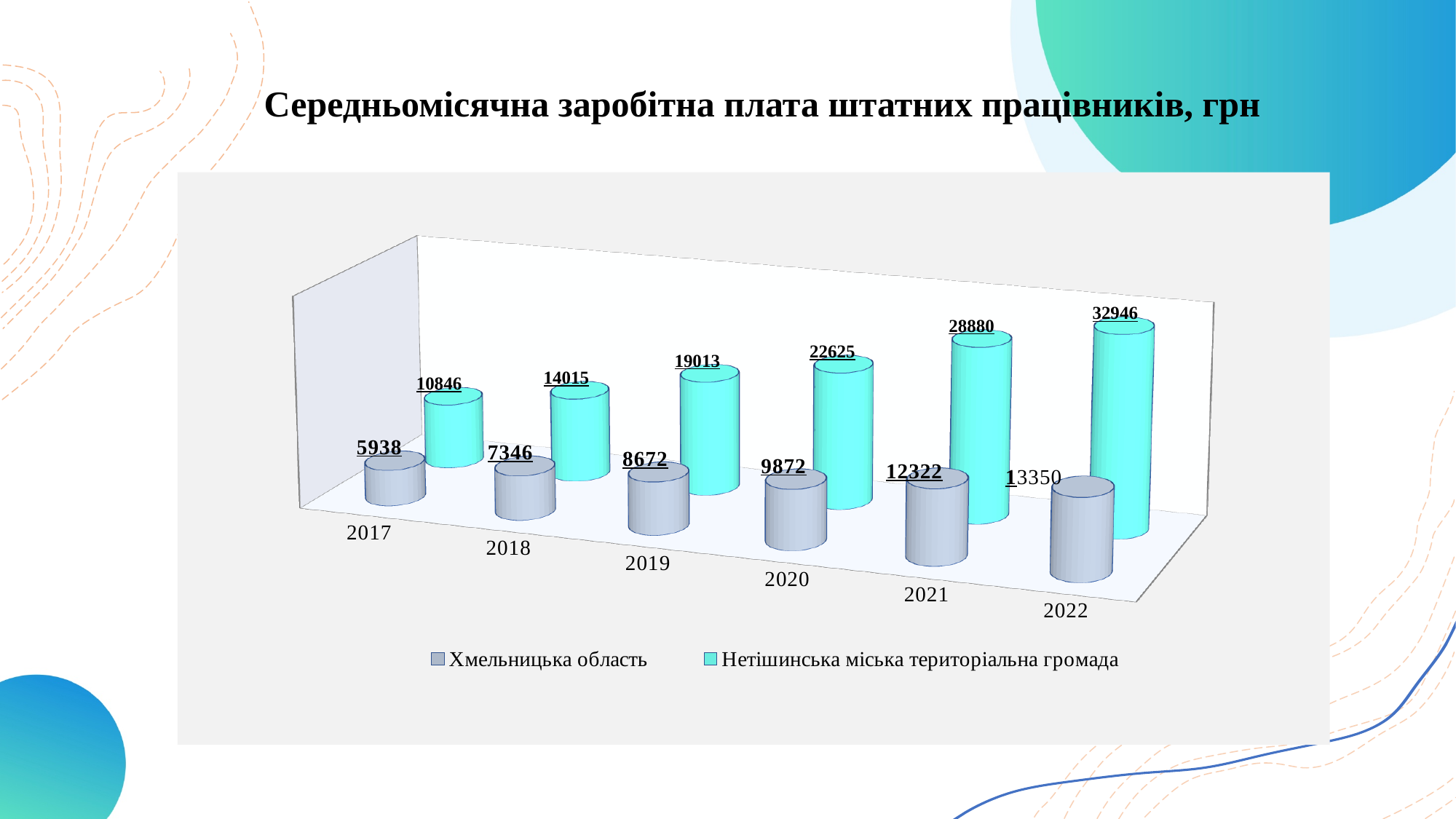
What is the value for Хмельницька область in 2017? 5938 In which year is the value for Хмельницька область lowest? 2017 How many series does the legend list? 2 How many years are shown on the x axis? 6 Do the values for Хмельницька область rise or fall from 2017 to 2022? Rise What is the difference between Нетішинська міська територіальна громада and Хмельницька область in 2020? 12753 What is the value for Хмельницька область in 2021? 12322 What is the value for Нетішинська міська територіальна громада in 2019? 19013 What is the value for Нетішинська міська територіальна громада in 2022? 32946 What kind of chart is shown on the slide? Bar chart In which year is the value for Нетішинська міська територіальна громада highest? 2022 Which series has the larger value in 2018, Хмельницька область or Нетішинська міська територіальна громада? Нетішинська міська територіальна громада